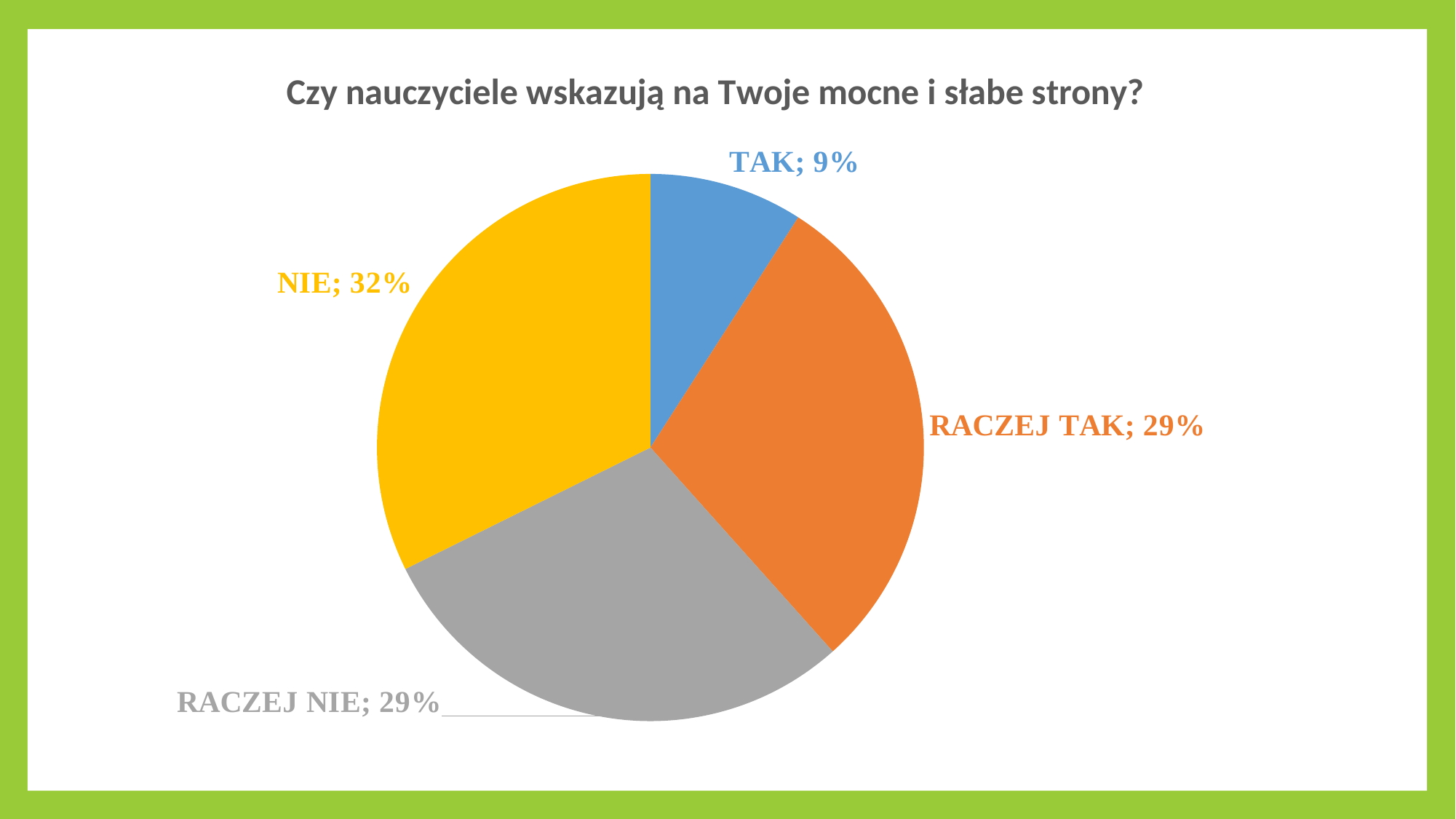
Which is larger, the share for NIE or the share for RACZEJ TAK? NIE Which category has the largest share of the pie? NIE What percentage is shown for NIE? 32% What colour is the slice for RACZEJ NIE? grey What is the chart's title? Czy nauczyciele wskazują na Twoje mocne i słabe strony? How many slices does the pie chart have? 4 What is the difference in percentage points between NIE and TAK? 23 What percentage is shown for RACZEJ TAK? 29% What percentage is shown for RACZEJ NIE? 29% Which category has the smallest share of the pie? TAK What type of chart is shown on the slide? pie chart What percentage is shown for TAK? 9%